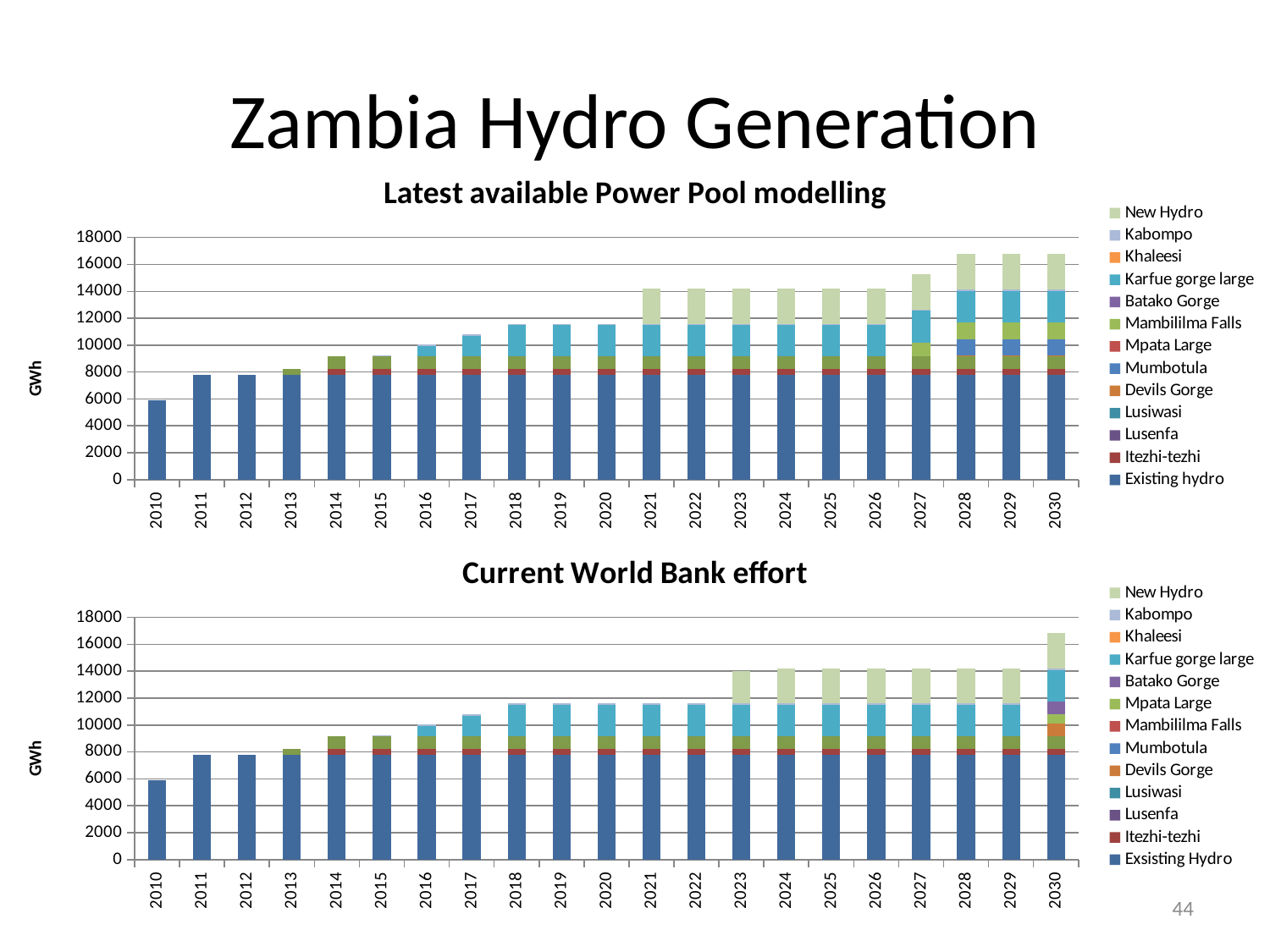
In the 'Latest available Power Pool modelling' chart, which year has the lowest total generation? 2010 In the 'Current World Bank effort' chart, which year has the larger total, 2022 or 2023? 2023 How many years are shown on the x axis of the 'Current World Bank effort' chart? 21 In the 'Latest available Power Pool modelling' chart, is the total for 2010 greater or less than 8000? less In the 'Current World Bank effort' chart, is the total for 2027 greater or less than 12000? greater In the 'Latest available Power Pool modelling' chart, which year has the larger total, 2026 or 2027? 2027 What is the label on the vertical axis of the 'Latest available Power Pool modelling' chart? GWh How many series does the legend of the 'Latest available Power Pool modelling' chart list? 13 In the 'Current World Bank effort' chart, do the total bar heights generally rise or fall from 2010 to 2030? rise In the 'Current World Bank effort' chart, which year has the highest total generation? 2030 What kind of chart is the 'Latest available Power Pool modelling' chart? Stacked bar chart In the 'Latest available Power Pool modelling' chart, is the total for 2030 greater or less than 16000? greater